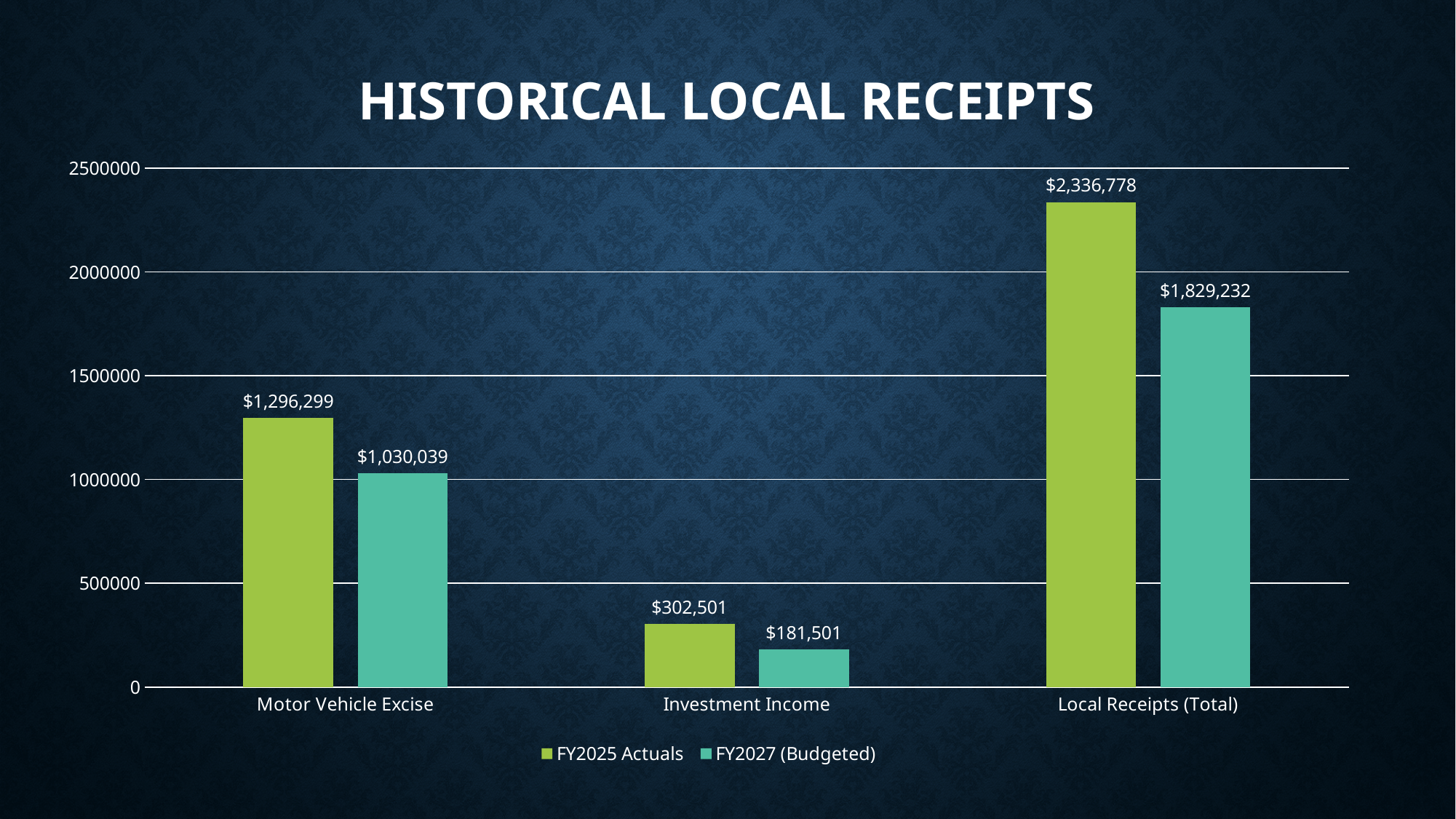
Is the FY2027 (Budgeted) value for Motor Vehicle Excise greater or less than 1000000? greater What is the difference between the FY2025 Actuals and FY2027 (Budgeted) values for Motor Vehicle Excise? $266,260 Which is larger for Local Receipts (Total): FY2025 Actuals or FY2027 (Budgeted)? FY2025 Actuals Which category has the lowest FY2027 (Budgeted) value? Investment Income What is the FY2025 Actuals value for Investment Income? $302,501 What is the FY2027 (Budgeted) value for Investment Income? $181,501 How many series does the legend list? 2 What is the FY2025 Actuals value for Motor Vehicle Excise? $1,296,299 Which category has the highest FY2025 Actuals value? Local Receipts (Total) What is the FY2027 (Budgeted) value for Local Receipts (Total)? $1,829,232 What type of chart is shown on the slide? Bar chart How many categories are shown on the x axis? 3